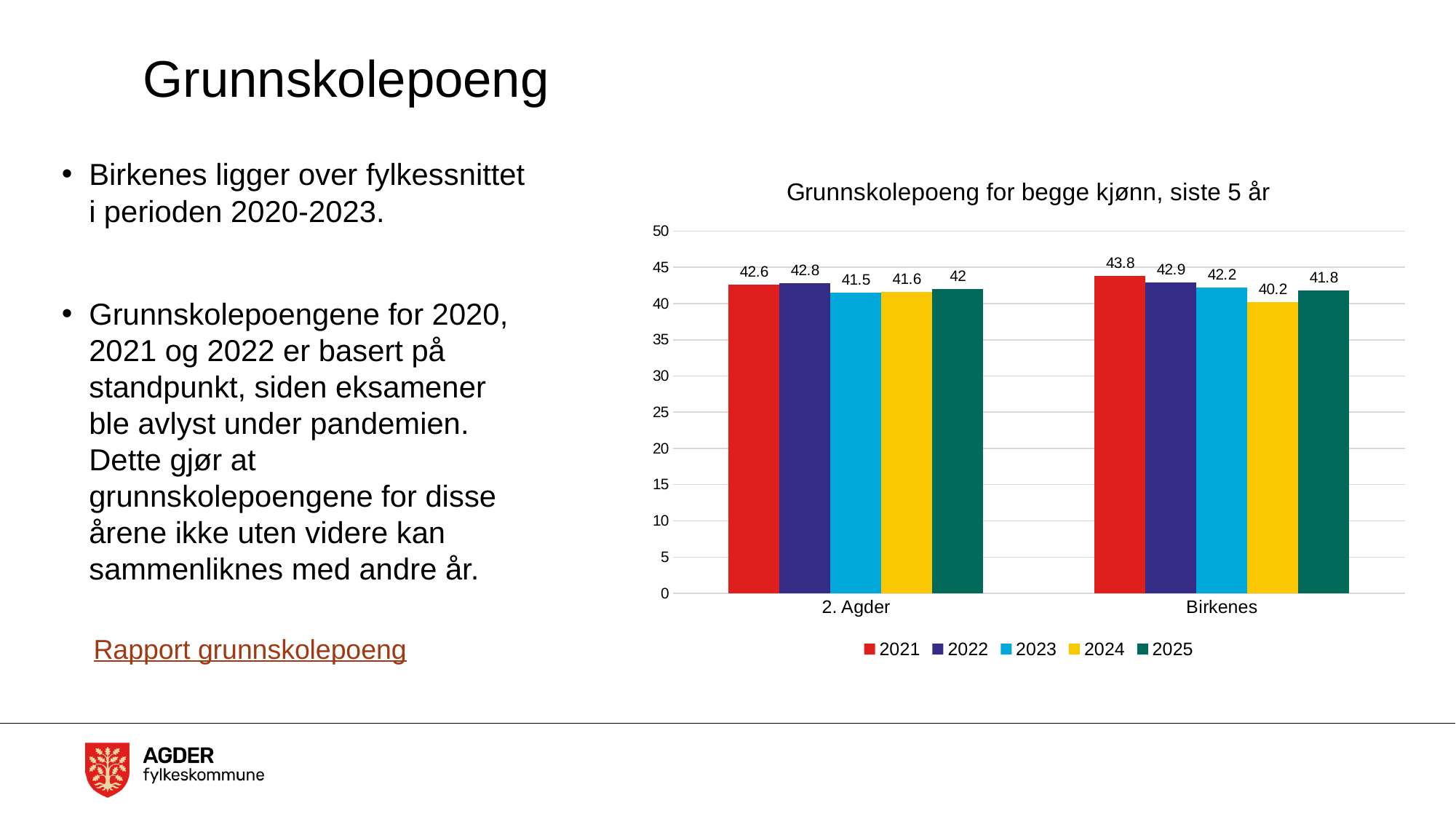
How many categories are shown on the x axis? 2 What is the value for Birkenes in 2024? 40.2 Which is larger, the 2024 value for 2. Agder or for Birkenes? 2. Agder How many series does the legend list? 5 What is the difference between the 2021 values for Birkenes and 2. Agder? 1.2 What is the title of the chart? Grunnskolepoeng for begge kjønn, siste 5 år What is the value for Birkenes in 2021? 43.8 What colour are the 2024 bars? Yellow What kind of chart is shown? Bar chart Which year has the highest value for Birkenes? 2021 What is the value for 2. Agder in 2025? 42 Which year has the lowest value for 2. Agder? 2023